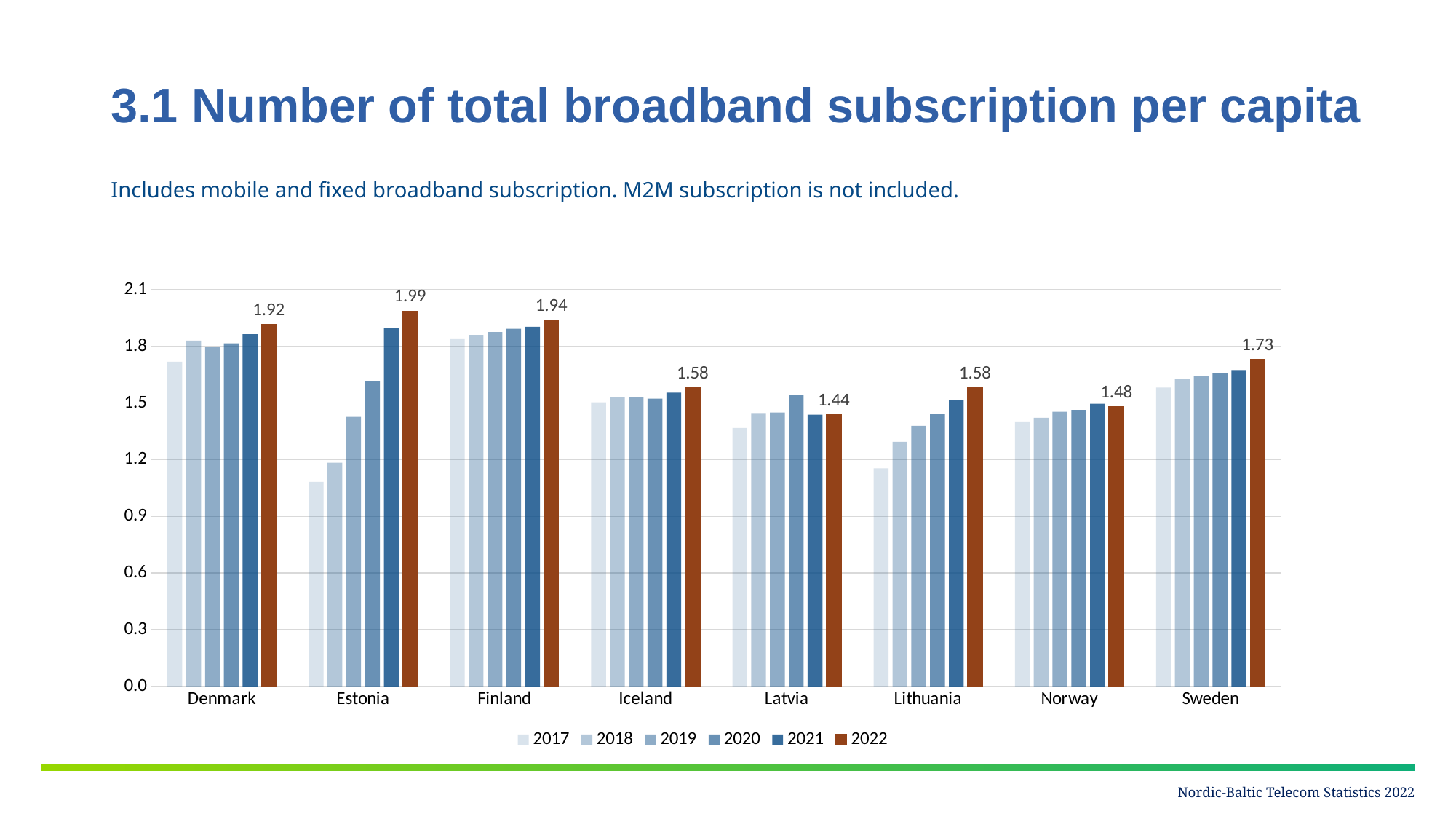
How many countries are shown on the x axis? 8 Which is larger, the 2022 value for Denmark or the 2022 value for Finland? Finland Which country has the highest 2022 value? Estonia Is the 2017 value for Lithuania greater or less than 1.2? less How many series does the legend list? 6 What is the 2022 value for Estonia? 1.99 Do the values for Estonia rise or fall from 2017 to 2022? rise Which country has the lowest 2022 value? Latvia What is the 2022 value for Latvia? 1.44 What is the difference between the 2022 values for Estonia and Norway? 0.51 What is the 2022 value for Sweden? 1.73 Is the 2017 value for Estonia greater or less than 1.2? less